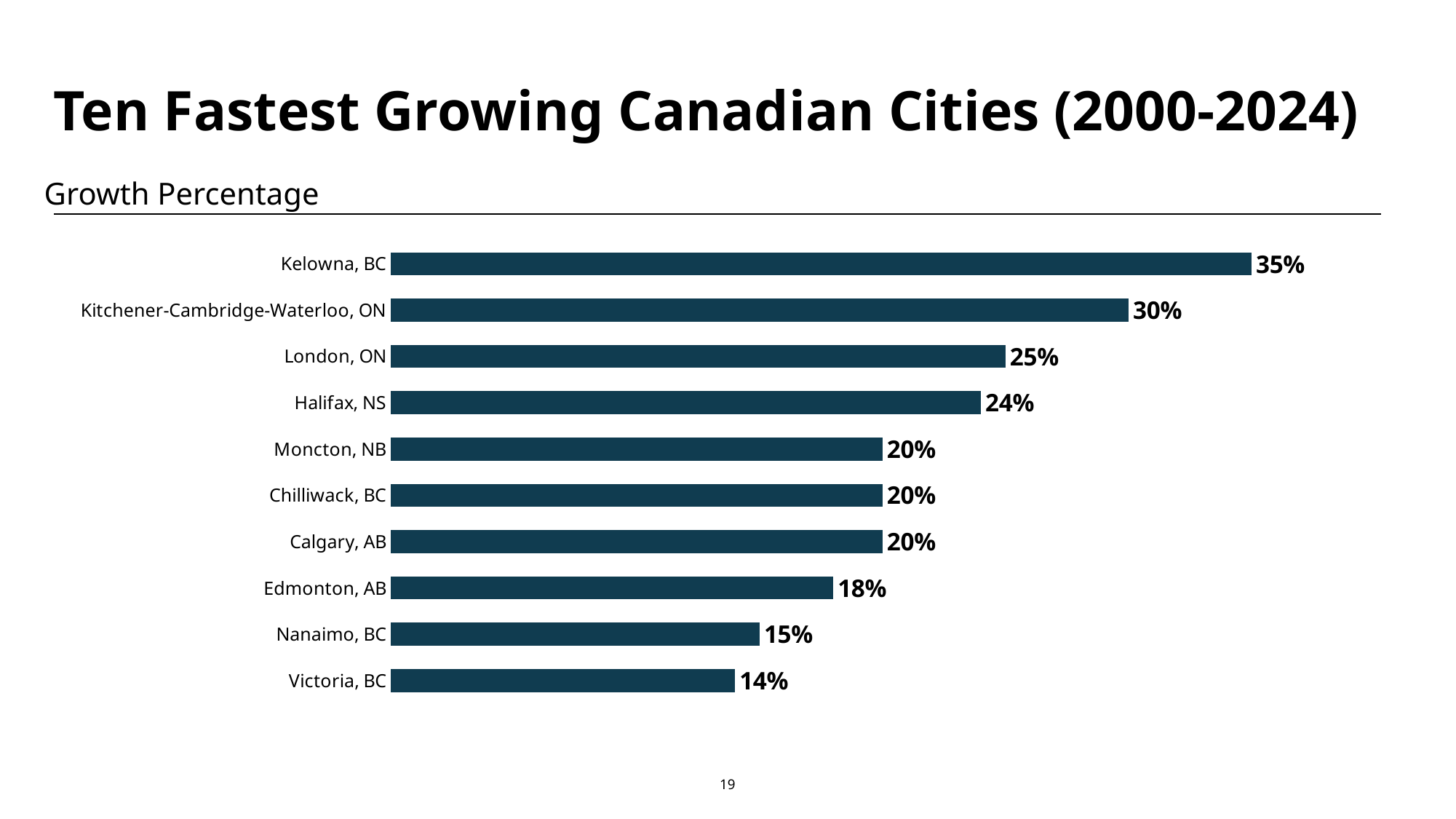
Which city has the highest growth percentage? Kelowna, BC What kind of chart is shown on the slide? Bar chart What is the difference in growth percentage between Kitchener-Cambridge-Waterloo, ON and London, ON? 5% How many cities are shown in the chart? 10 How many cities have a growth percentage of exactly 20%? 3 Which has a higher growth percentage, Nanaimo, BC or Edmonton, AB? Edmonton, AB What is the growth percentage for Kelowna, BC? 35% What is the difference in growth percentage between Kelowna, BC and Victoria, BC? 21% What is the growth percentage for Edmonton, AB? 18% What is the growth percentage for Halifax, NS? 24% Which city has the lowest growth percentage? Victoria, BC What is the title of the slide? Ten Fastest Growing Canadian Cities (2000-2024)